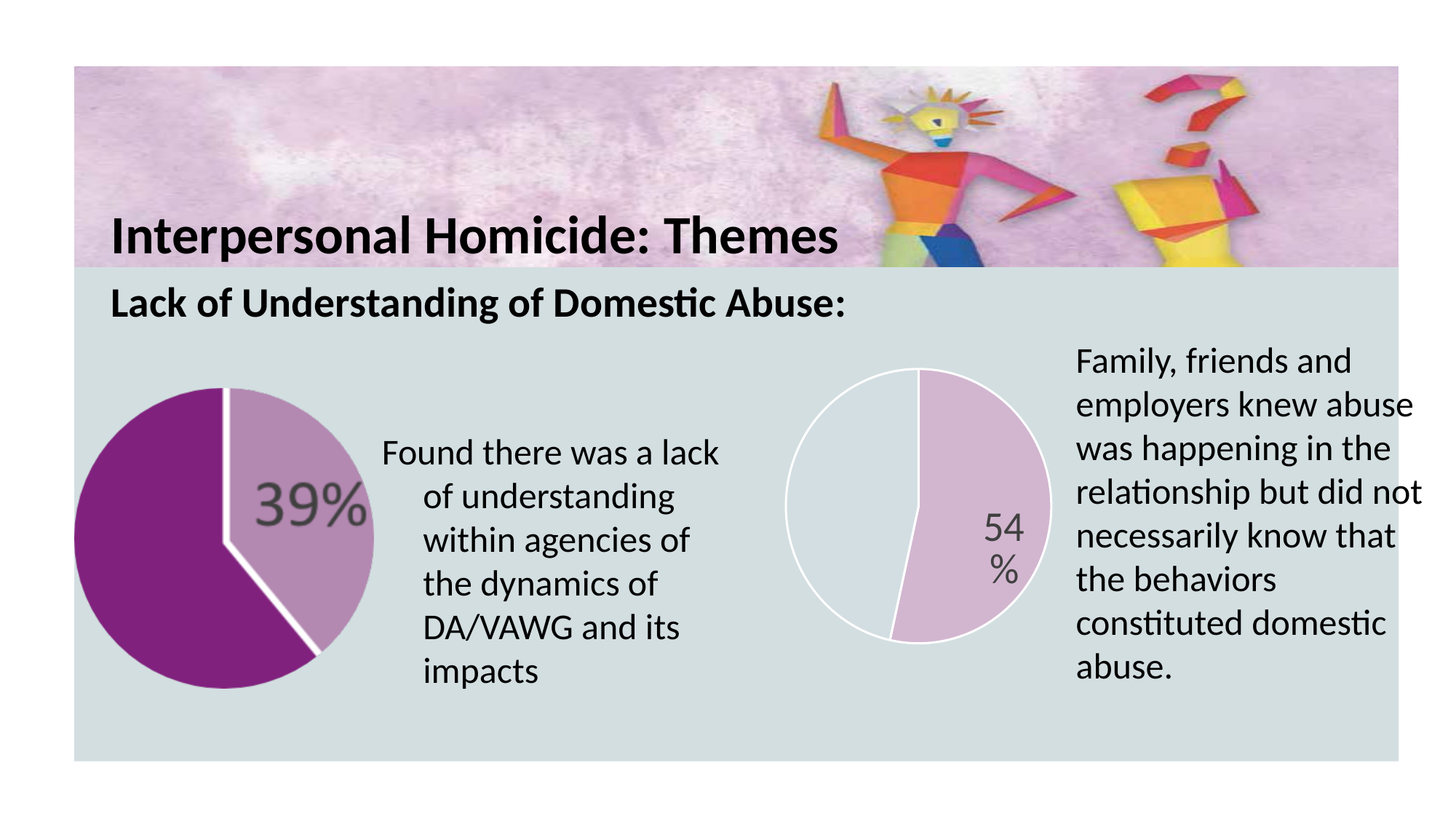
In the left pie chart, is the labelled slice greater or less than 50% of the pie? less What kind of chart is the right chart on the slide? Pie chart Which is larger: the labelled value in the left pie chart or the labelled value in the right pie chart? The right pie chart (54%) In the left pie chart, which slice is larger: the dark purple slice or the light purple slice labelled 39%? The dark purple slice In the right pie chart, is the labelled slice greater or less than 50% of the pie? greater What is the difference between the labelled value in the right pie chart (54%) and the labelled value in the left pie chart (39%)? 15 percentage points What colour is the slice labelled 39% in the left pie chart? Light purple In the right pie chart, what percentage is printed on the labelled slice? 54% How many slices does the right pie chart have? 2 How many slices does the left pie chart have? 2 What kind of chart is the left chart on the slide? Pie chart In the left pie chart, what percentage is printed on the labelled slice? 39%